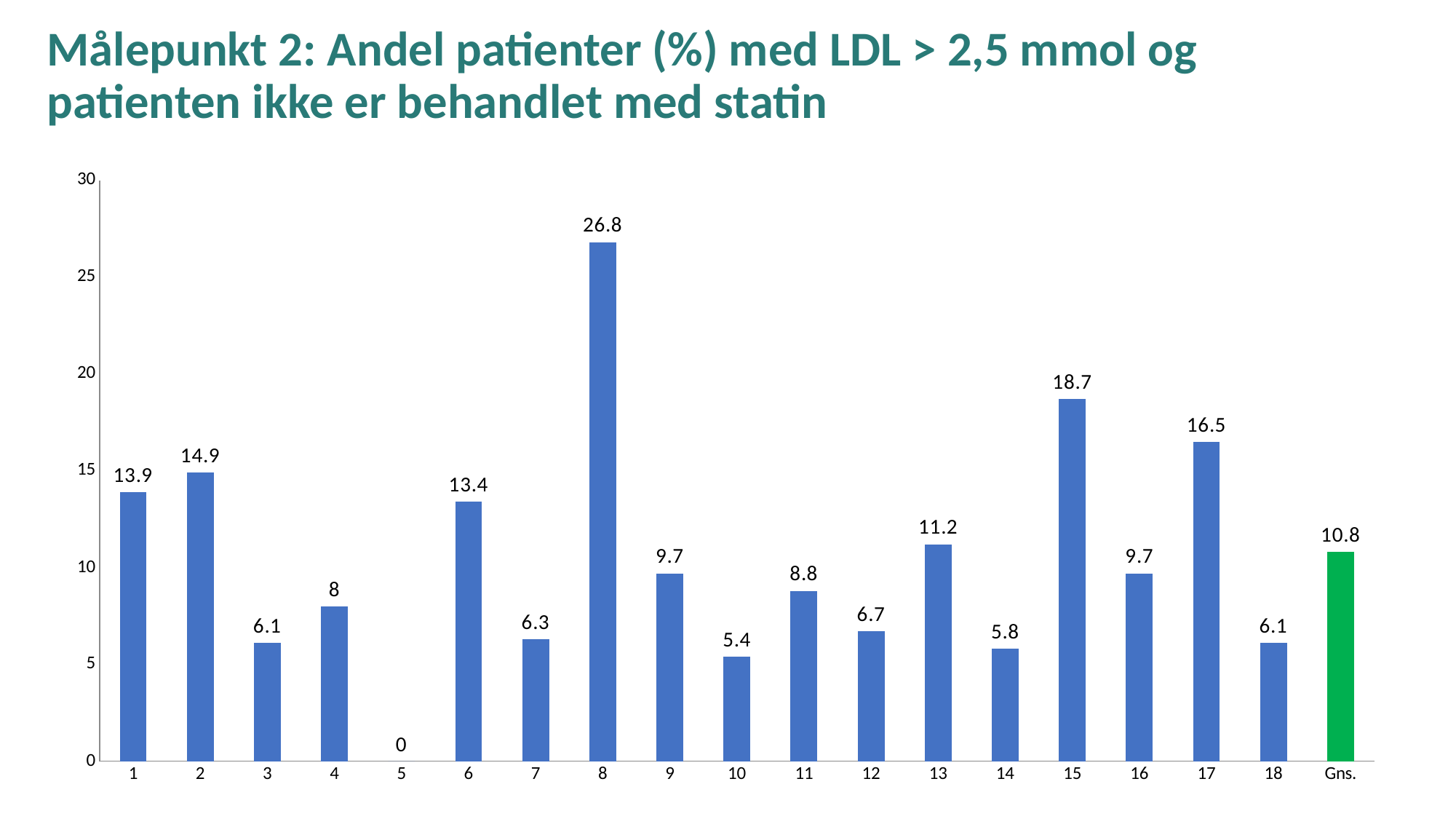
Which bar is shown in green rather than blue? Gns. Which is larger, the value for category 2 or the value for category 6? 2 Which category has the lowest value? 5 What is the difference between the value for category 1 and the Gns. value? 3.1 What kind of chart is shown on the slide? bar chart What is the value for Gns.? 10.8 What is the value for category 8? 26.8 What is the value for category 15? 18.7 Which category has the highest value? 8 Is the value for category 17 greater or less than 15? greater What is the difference between the values for category 8 and category 15? 8.1 How many categories are shown on the x axis? 19